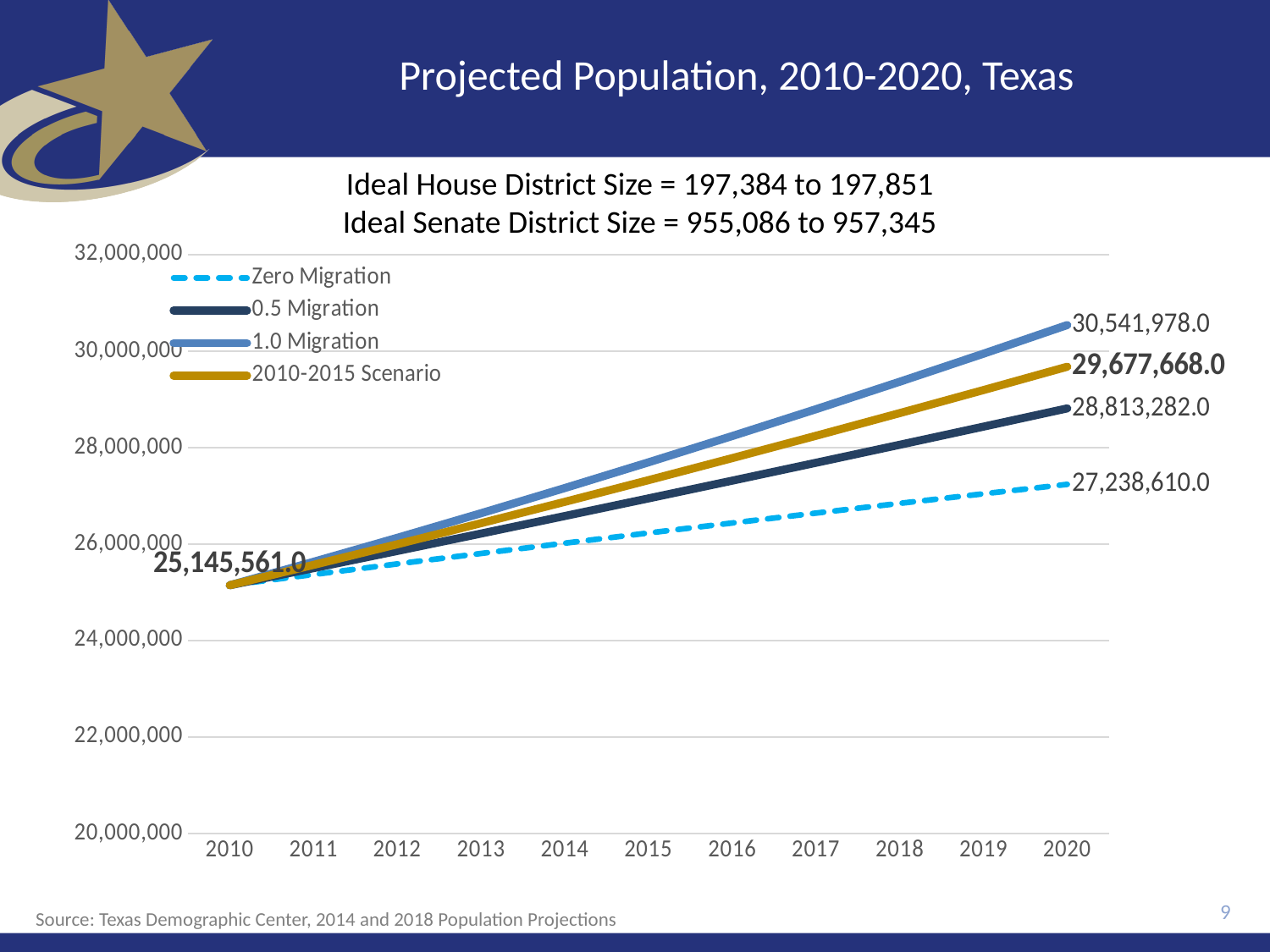
Do the projected population values rise or fall from 2010 to 2020? rise What is the projected population for the Zero Migration series in 2020? 27,238,610.0 What kind of chart is shown on the slide? line chart How many series does the legend list? 4 What is the projected population for the 1.0 Migration series in 2020? 30,541,978.0 Is the 2020 value for the 0.5 Migration series greater or less than 28,000,000? greater What is the projected population for the 2010-2015 Scenario series in 2020? 29,677,668.0 Which series has the lowest projected population in 2020? Zero Migration Which series has the highest projected population in 2020? 1.0 Migration What is the projected population for the 0.5 Migration series in 2020? 28,813,282.0 What is the population value shown for 2010? 25,145,561.0 What is the difference between the 1.0 Migration and Zero Migration values in 2020? 3,303,368.0